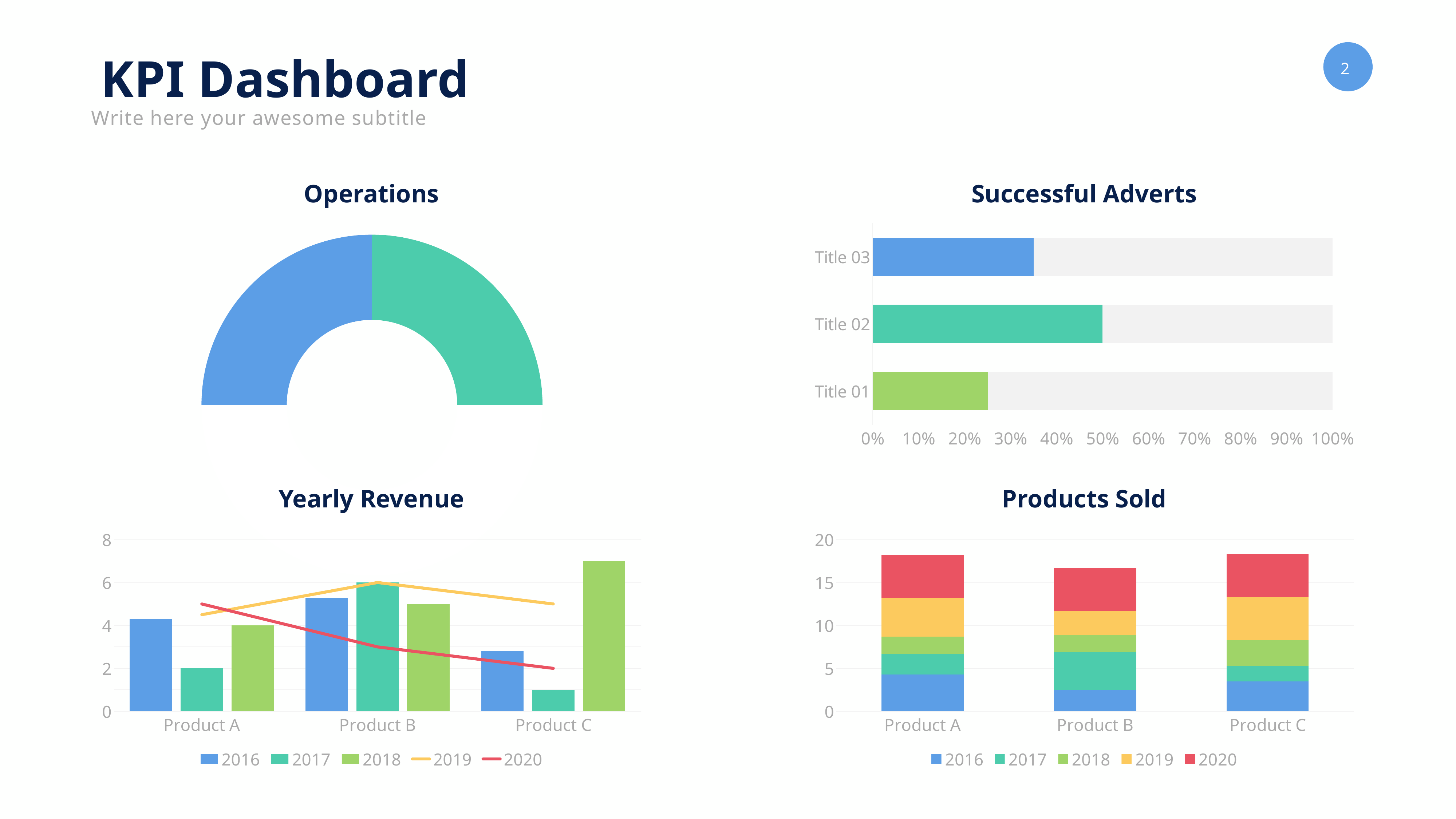
How many series does the legend of the Products Sold chart list? 5 What kind of chart is the Products Sold chart? stacked bar chart In the Successful Adverts chart, which title has the lowest value? Title 01 In the Yearly Revenue chart, which product has the highest 2018 bar? Product C In the Yearly Revenue chart, does the 2020 line rise or fall from Product A to Product C? fall In the Yearly Revenue chart, is the 2016 value for Product A greater or less than 4? greater In the Successful Adverts chart, is the value for Title 03 greater or less than 30%? greater In the Successful Adverts chart, which title has the highest value? Title 02 How many series does the legend of the Yearly Revenue chart list? 5 In the Successful Adverts chart, is the value for Title 01 greater or less than 30%? less How many categories are shown in the Successful Adverts chart? 3 In the Yearly Revenue chart, which product has the lowest 2017 bar? Product C